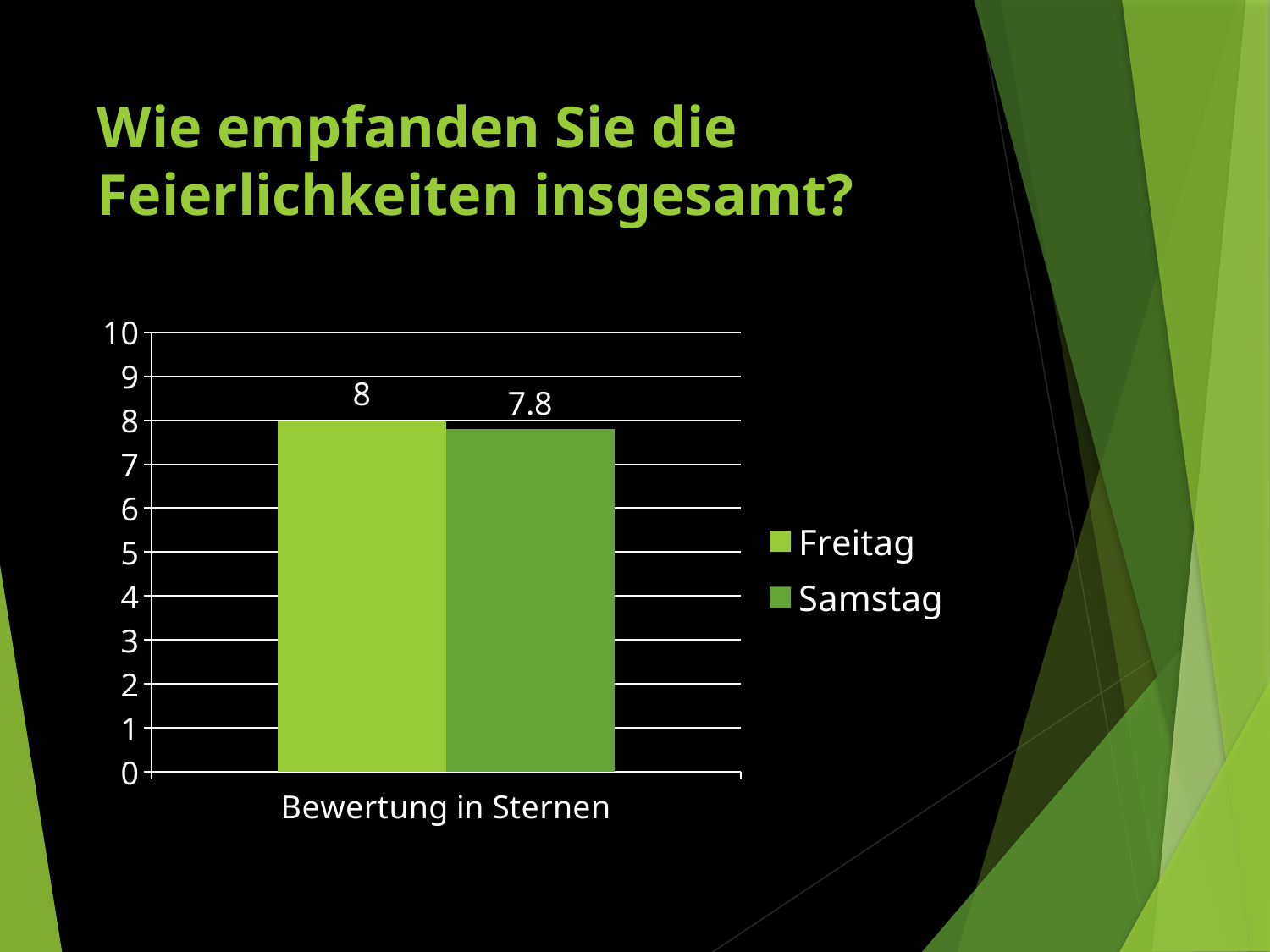
What is the category label shown on the x axis? Bewertung in Sternen What kind of chart is shown on the slide? bar chart Which series has the lowest value? Samstag What is the value for Freitag? 8 Is the value for Samstag greater or less than 9? less What is the maximum value shown on the y axis? 10 How many bars are plotted in the chart? 2 How many series does the legend list? 2 What is the value for Samstag? 7.8 Which series has the higher value, Freitag or Samstag? Freitag What is the difference between the Freitag and Samstag values? 0.2 Is the value for Freitag greater or less than 5? greater